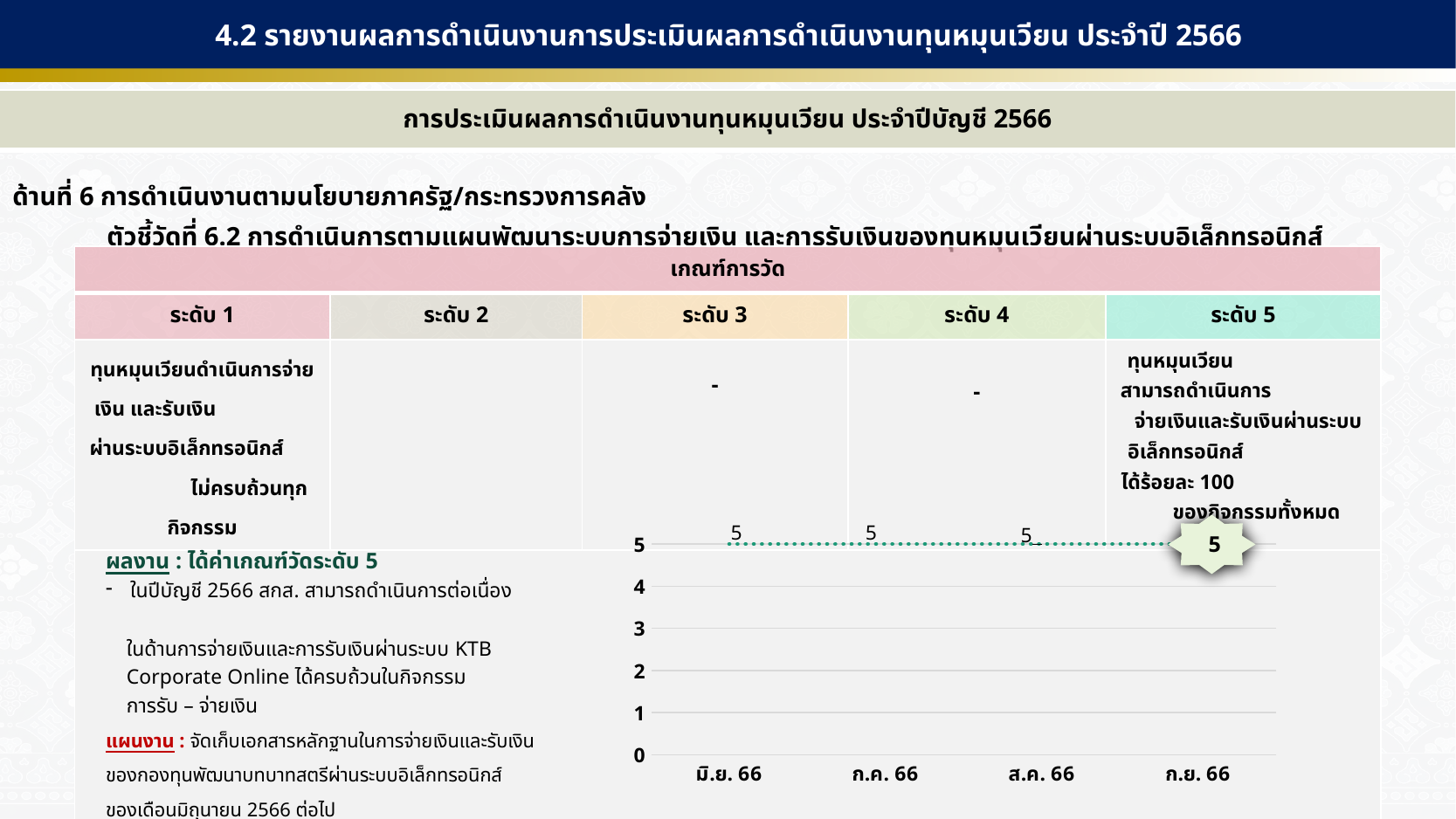
What is the value for มิ.ย. 66 on the chart? 5 Do the values rise, fall, or stay flat from มิ.ย. 66 to ก.ย. 66? stay flat What kind of chart is shown on the slide? line chart What is the highest value shown on the vertical axis of the chart? 5 What is the difference between the values for มิ.ย. 66 and ก.ย. 66? 0 What is the value for ส.ค. 66 on the chart? 5 What is the value for ก.ค. 66 on the chart? 5 What is the value for ก.ย. 66 on the chart? 5 What is the label of the first category on the x axis? มิ.ย. 66 Is the value for ส.ค. 66 greater or less than 3? greater How many points are plotted on the chart? 4